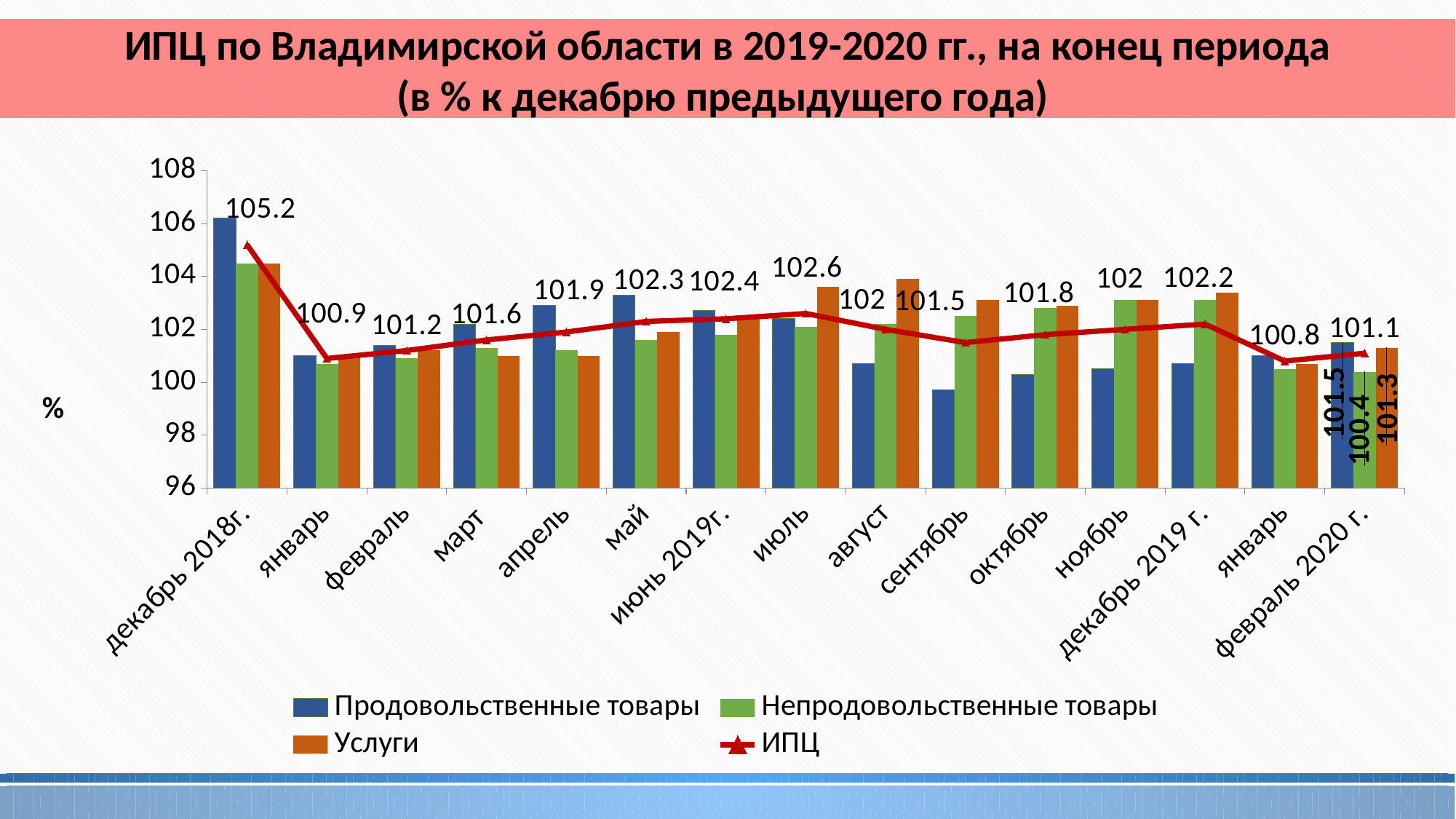
Which has the larger ИПЦ value, май or сентябрь? май What kind of chart is this? Bar chart combined with a line What is the difference between the ИПЦ value for декабрь 2018г. and the ИПЦ value for the following январь? 4.3 What is the value for Продовольственные товары in февраль 2020 г.? 101.5 Which period has the highest ИПЦ value? декабрь 2018г. Does the ИПЦ line rise or fall from январь 2019 to июль? rises What is the ИПЦ value for март? 101.6 Which period has the lowest ИПЦ value? январь 2020 (100.8) Is the value for Продовольственные товары in сентябрь greater or less than 100? less What is the ИПЦ value for июль? 102.6 How many series does the legend list? 4 How many periods are shown on the x axis? 15